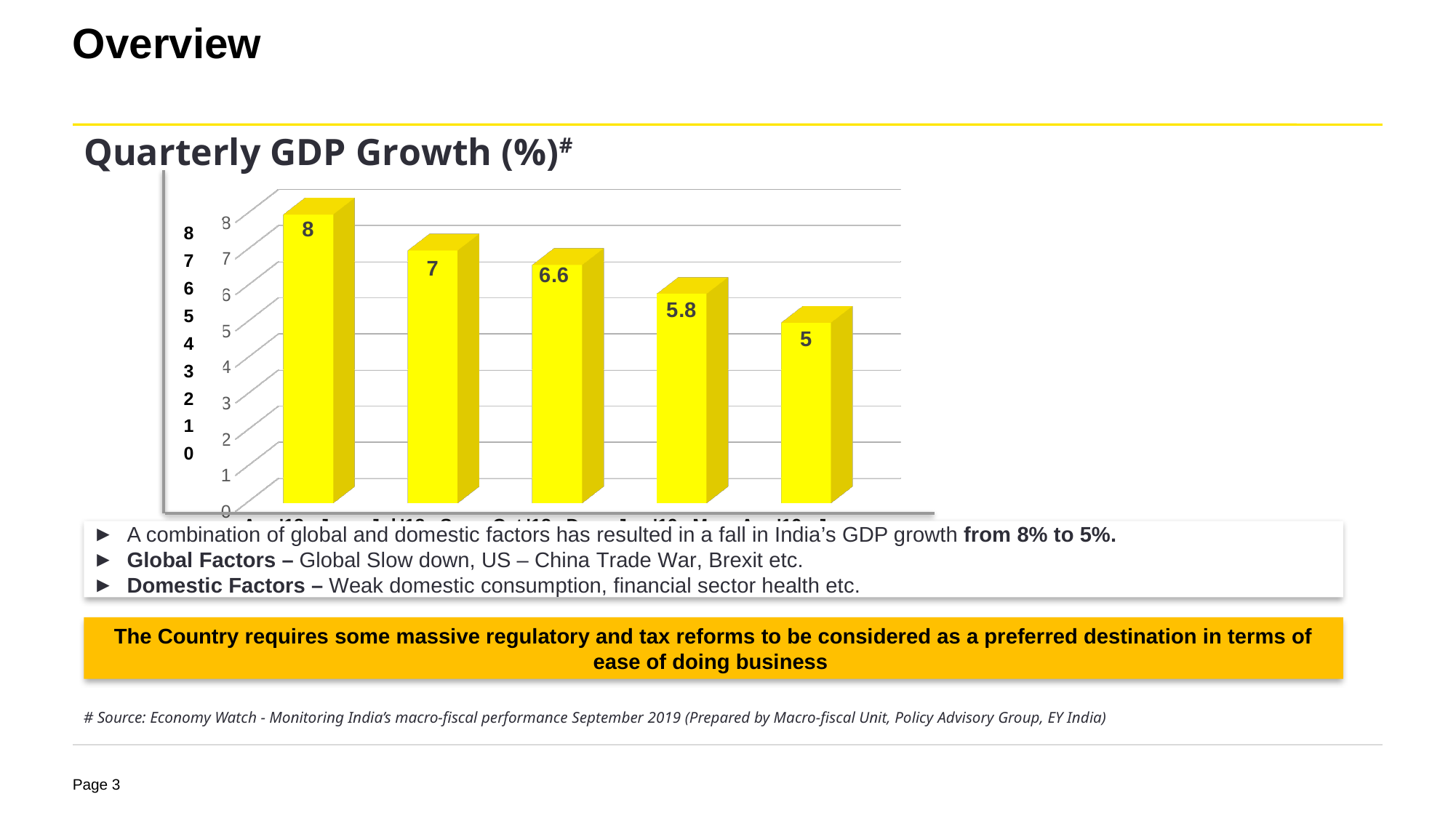
Do the values in the Quarterly GDP Growth (%) chart rise or fall from left to right? Fall How many bars are plotted in the Quarterly GDP Growth (%) chart? 5 What colour are the bars in the Quarterly GDP Growth (%) chart? Yellow Which is larger in the Quarterly GDP Growth (%) chart: the second bar or the fourth bar? The second bar (7) Which bar has the lowest value in the Quarterly GDP Growth (%) chart? The last (rightmost) bar, 5 What kind of chart is shown under the title "Quarterly GDP Growth (%)"? Bar chart Which bar has the highest value in the Quarterly GDP Growth (%) chart? The first (leftmost) bar, 8 What is the value shown on the third bar of the Quarterly GDP Growth (%) chart? 6.6 What is the value shown on the fourth bar of the Quarterly GDP Growth (%) chart? 5.8 What is the difference between the first bar and the last bar in the Quarterly GDP Growth (%) chart? 3 What is the value shown on the first (leftmost) bar of the Quarterly GDP Growth (%) chart? 8 What is the value shown on the last (rightmost) bar of the Quarterly GDP Growth (%) chart? 5